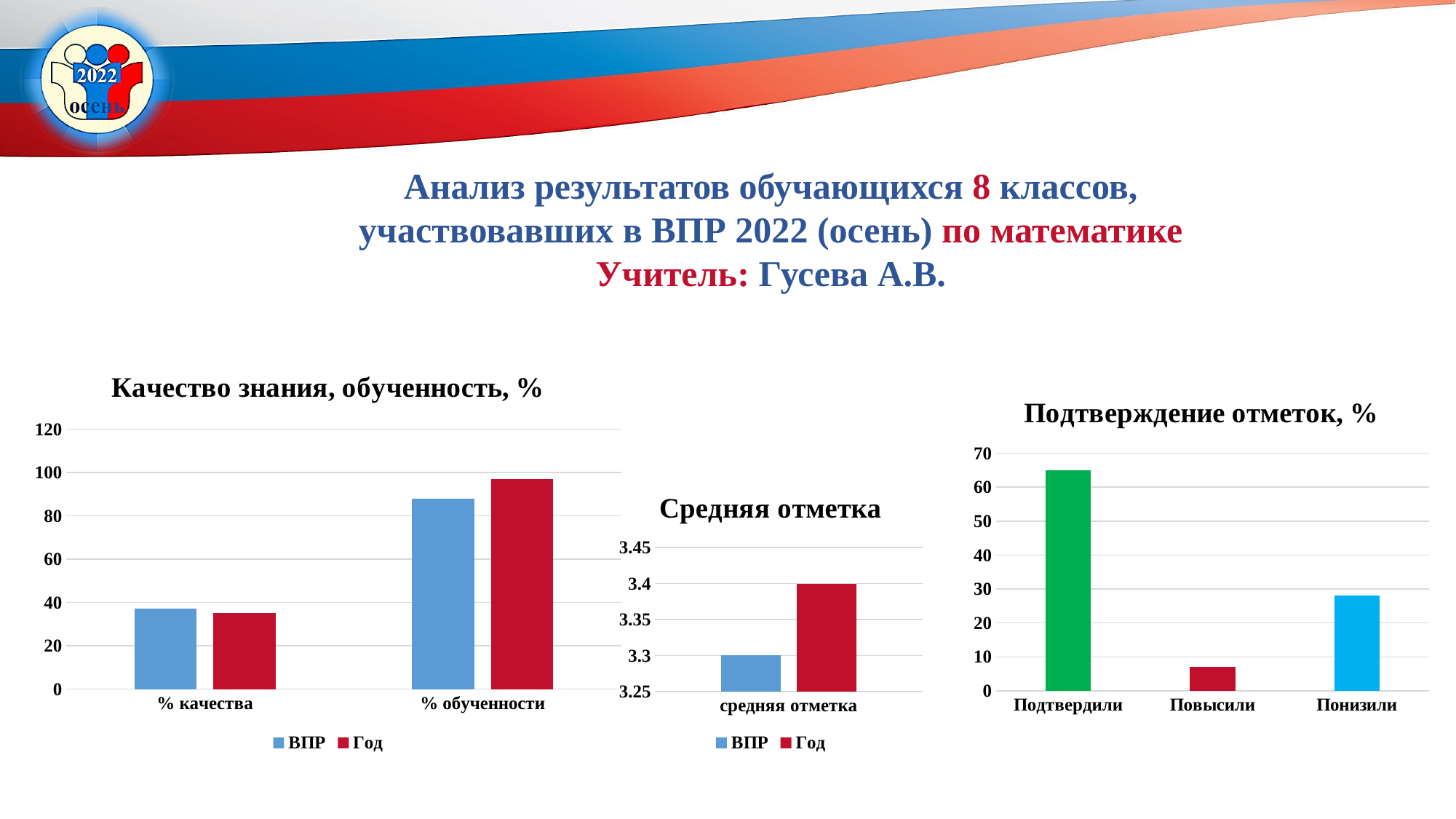
In the chart titled "Средняя отметка", what is the value for ВПР? 3.3 In the chart titled "Подтверждение отметок, %", which category has the lowest value? Повысили In the chart titled "Качество знания, обученность, %", is the ВПР value for % качества greater or less than 40? less In the chart titled "Подтверждение отметок, %", how many categories are shown on the x axis? 3 In the chart titled "Качество знания, обученность, %", for % обученности, which series has the larger value, ВПР or Год? Год In the chart titled "Подтверждение отметок, %", is the value for Повысили greater or less than 10? less In the chart titled "Подтверждение отметок, %", which category has the highest value? Подтвердили In the chart titled "Средняя отметка", what is the value for Год? 3.4 In the chart titled "Средняя отметка", what is the difference between the Год value and the ВПР value? 0.1 In the chart titled "Подтверждение отметок, %", is the value for Подтвердили greater or less than 60? greater In the chart titled "Качество знания, обученность, %", how many series does the legend list? 2 In the chart titled "Средняя отметка", which series has the larger value, ВПР or Год? Год